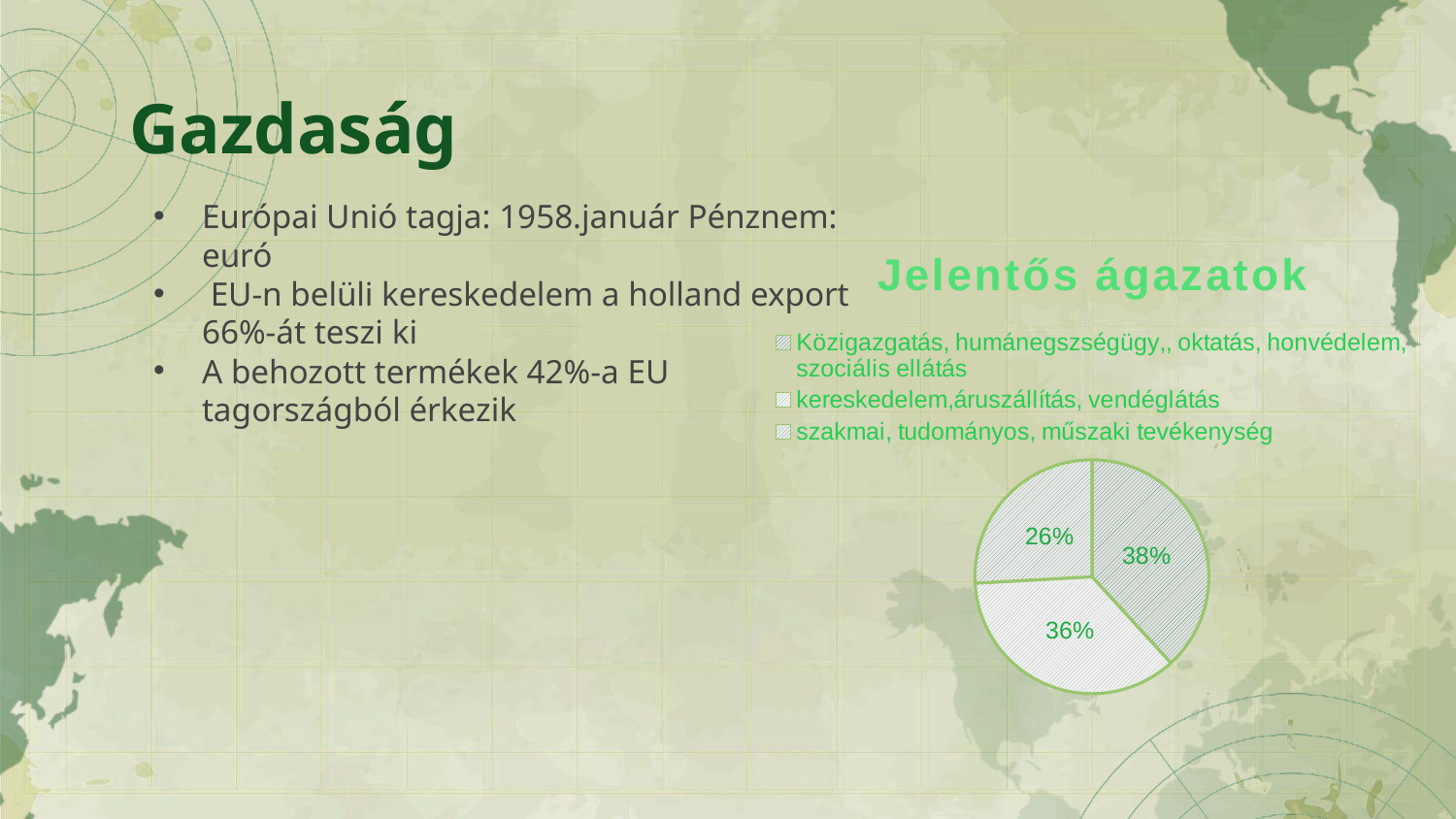
What kind of chart is shown under the heading "Jelentős ágazatok"? pie chart How many slices does the pie chart have? 3 What is the value of the smallest slice in the pie chart? 26% What is the title of the chart on the slide? Jelentős ágazatok What is the difference between the largest and smallest slices of the pie chart? 12% What do the three slices of the pie chart add up to? 100% What is the third legend entry of the pie chart? szakmai, tudományos, műszaki tevékenység What is the difference between the 38% slice and the 36% slice in the pie chart? 2% How many entries does the legend of the pie chart list? 3 Which is larger in the pie chart, the 36% slice or the 26% slice? the 36% slice What is the value of the largest slice in the pie chart? 38%